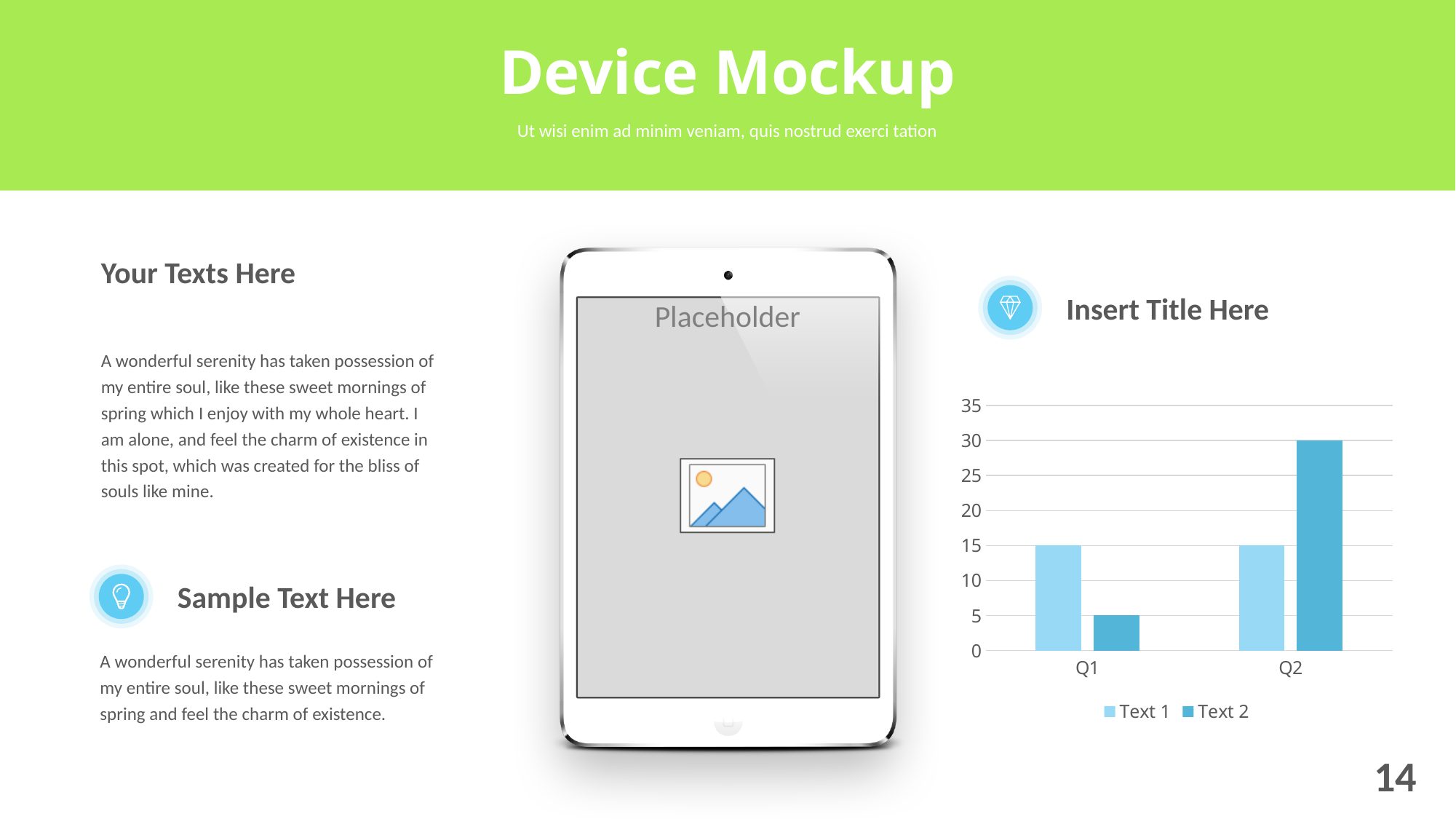
In the bar chart, which is larger for Q2: Text 1 or Text 2? Text 2 In the bar chart, what is the difference between Text 2 for Q2 and Text 2 for Q1? 25 How many categories are shown on the x axis of the bar chart? 2 In the bar chart, what is the value of Text 1 for Q1? 15 How many series does the legend of the bar chart list? 2 In the bar chart, which category has the highest value for Text 2? Q2 In the bar chart, does the value of Text 2 rise or fall from Q1 to Q2? rise What type of chart is shown on the right side of the slide? bar chart In the bar chart, what is the value of Text 2 for Q1? 5 In the bar chart, which category has the lowest value for Text 2? Q1 In the bar chart, what is the value of Text 2 for Q2? 30 In the bar chart, what is the value of Text 1 for Q2? 15